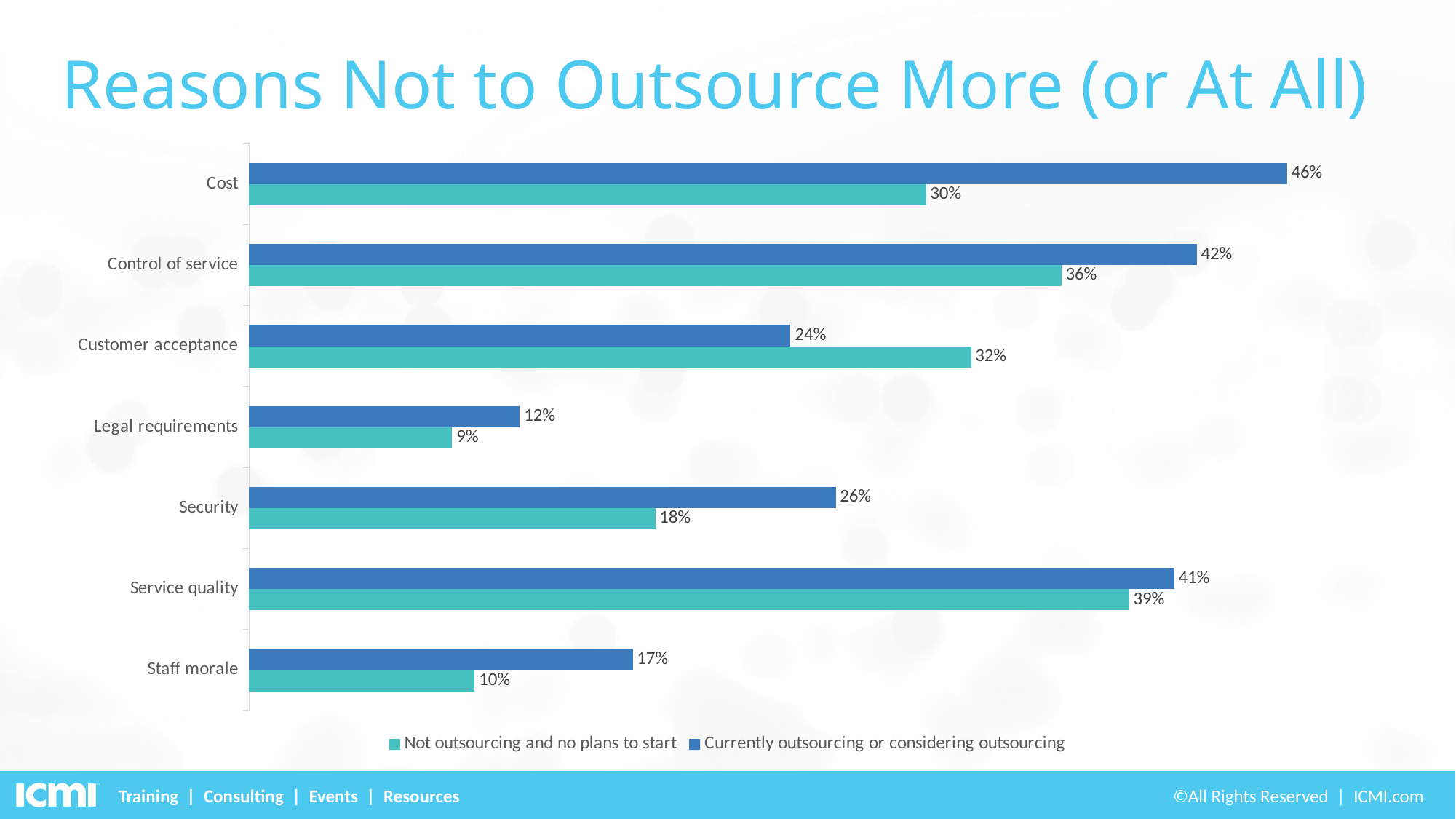
How many categories are shown on the chart? 7 What is the title of the chart on the slide? Reasons Not to Outsource More (or At All) Which category has the highest value in the 'Currently outsourcing or considering outsourcing' series? Cost What is the value for Customer acceptance in the 'Not outsourcing and no plans to start' series? 32% What is the difference between the two series' values for Security? 8% For Customer acceptance, which series has the larger value? Not outsourcing and no plans to start Which category has the lowest value in the 'Not outsourcing and no plans to start' series? Legal requirements What is the value for Legal requirements in the 'Not outsourcing and no plans to start' series? 9% What is the difference between the two series' values for Cost? 16% What kind of chart is shown on the slide? Bar chart How many series does the legend list? 2 What is the value for Cost in the 'Currently outsourcing or considering outsourcing' series? 46%